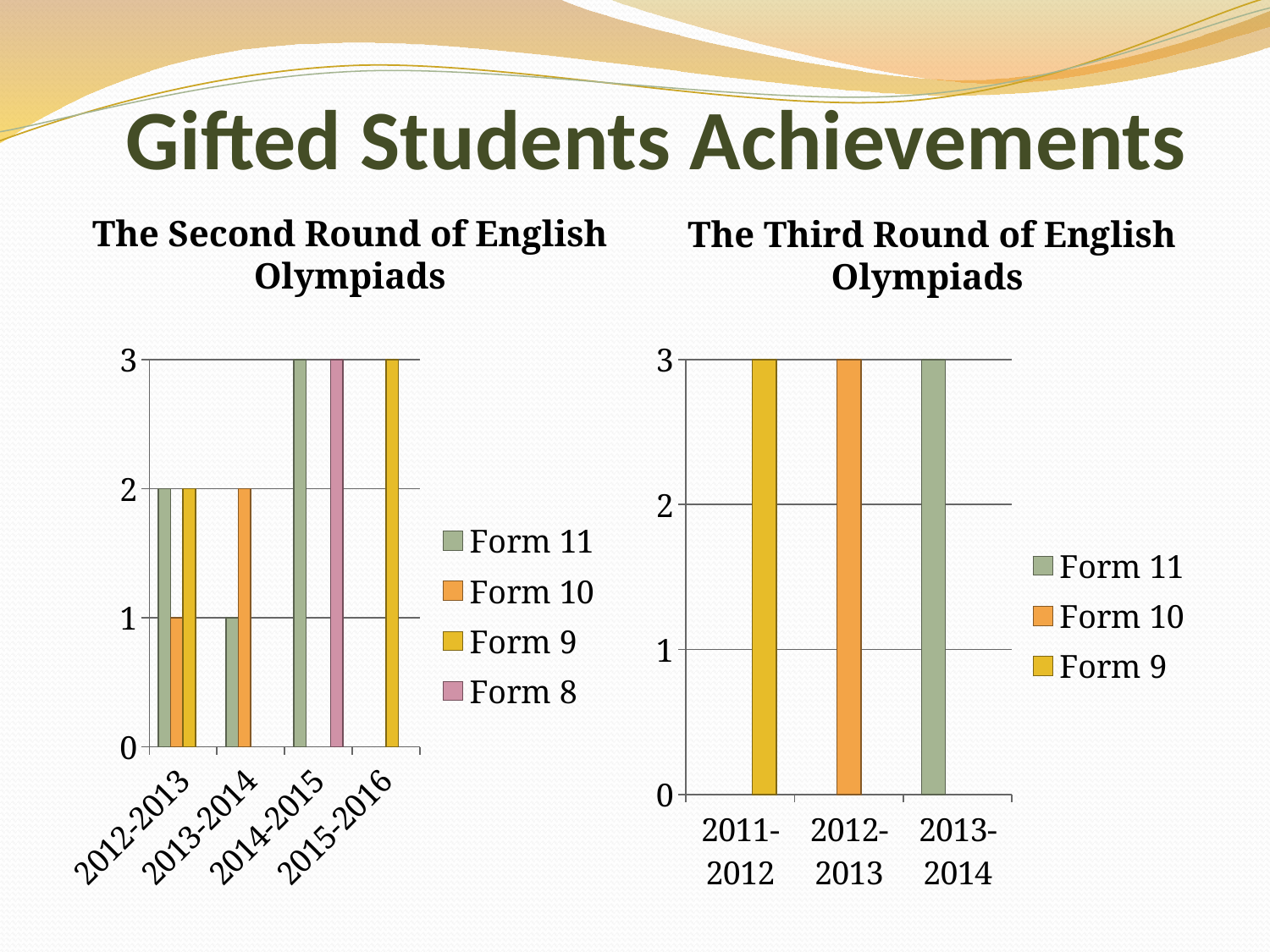
In "The Second Round of English Olympiads" chart, what is the value for Form 11 in 2014-2015? 3 In "The Second Round of English Olympiads" chart, is the Form 11 value larger in 2012-2013 or in 2013-2014? 2012-2013 What is the title of the chart on the right side of the slide? The Third Round of English Olympiads In "The Second Round of English Olympiads" chart, what is the difference between Form 11 and Form 10 in 2012-2013? 1 How many series does the legend of "The Second Round of English Olympiads" chart list? 4 In "The Second Round of English Olympiads" chart, what is the value for Form 10 in 2012-2013? 1 In "The Second Round of English Olympiads" chart, what is the value for Form 9 in 2015-2016? 3 What kind of chart is "The Second Round of English Olympiads"? bar chart In "The Third Round of English Olympiads" chart, what is the value for Form 10 in 2012-2013? 3 How many academic years are shown on the x axis of "The Second Round of English Olympiads" chart? 4 How many series does the legend of "The Third Round of English Olympiads" chart list? 3 How many academic years are shown on the x axis of "The Third Round of English Olympiads" chart? 3